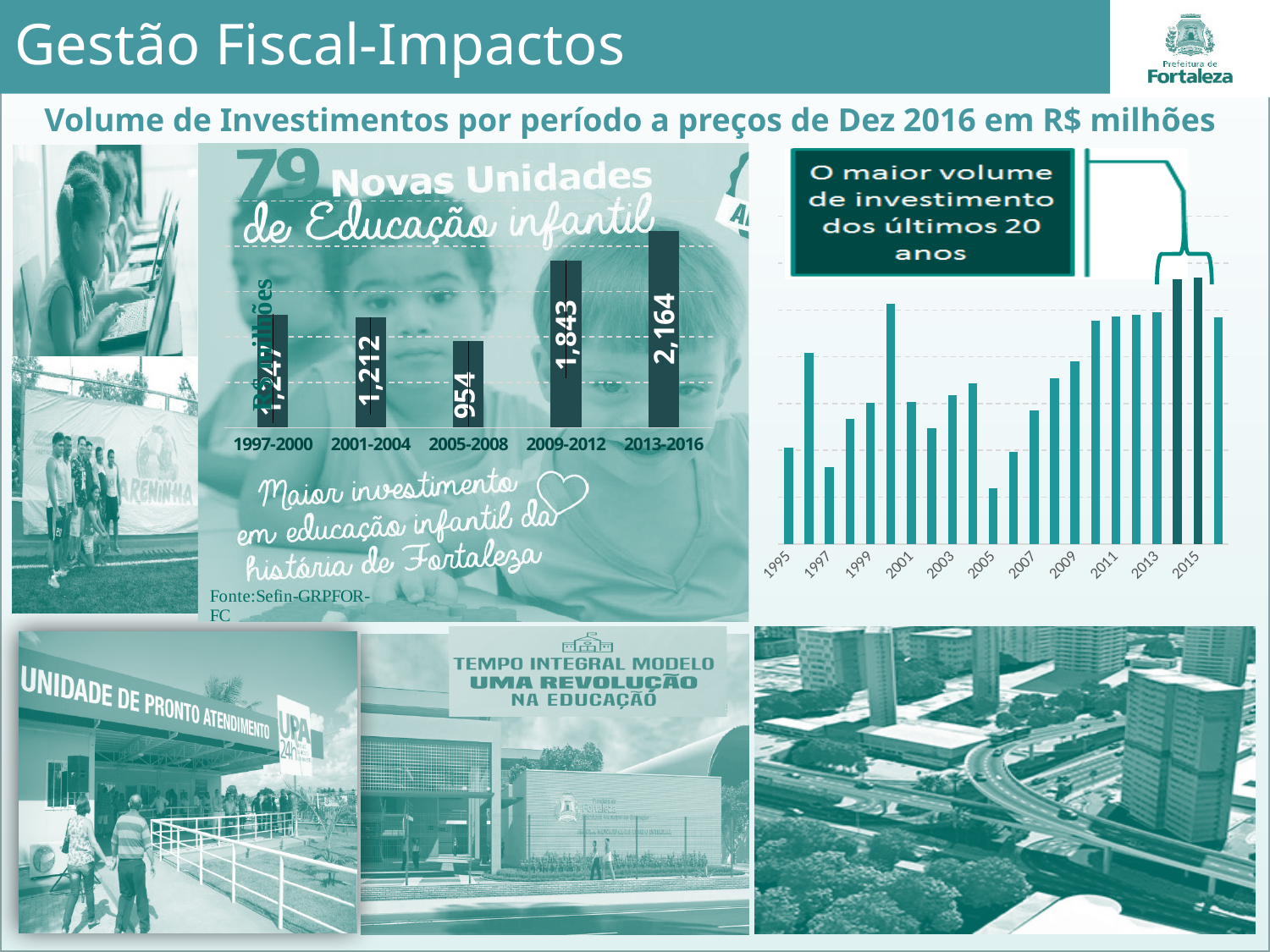
On the chart by period (left), what is the investment value for 2013-2016? 2,164 On the yearly chart (right), which year has the lowest bar? 2005 On the yearly chart (right), how many years are plotted? 22 On the chart by period (left), how many periods are shown? 5 On the chart by period (left), which period has the highest investment? 2013-2016 On the chart by period (left), what is the investment value for 2009-2012? 1,843 On the yearly chart (right), which is larger, the bar for 2001 or the bar for 1997? 2001 On the chart by period (left), what is the difference between the 2013-2016 and 2009-2012 values? 321 On the chart by period (left), which period has the lowest investment? 2005-2008 On the chart by period (left), what is the investment value for 2001-2004? 1,212 On the chart by period (left), what is the difference between the 2001-2004 and 2005-2008 values? 258 On the chart by period (left), what is the investment value for 2005-2008? 954